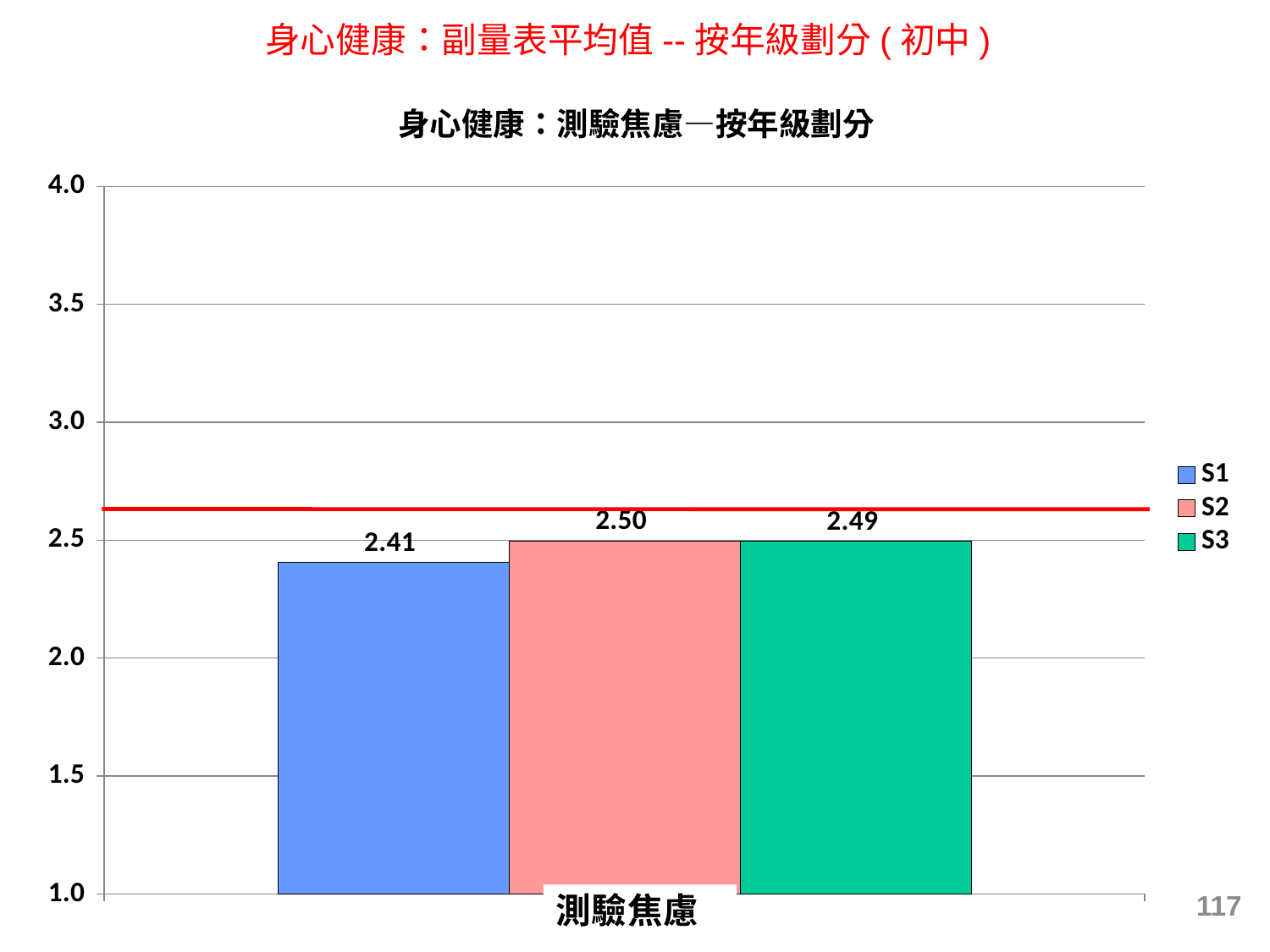
How many series does the legend list? 3 Which series has the highest value in the chart? S2 What kind of chart is shown on the slide? bar chart What is the value for S2 in the 測驗焦慮 chart? 2.50 Which series has the lowest value in the chart? S1 Is the value for S1 greater or less than 2.5? less What is the value for S3 in the 測驗焦慮 chart? 2.49 What is the difference between the S2 and S1 values? 0.09 Which is larger, the value for S1 or the value for S3? S3 What is the difference between the S3 and S1 values? 0.08 What is the title of the chart? 身心健康：測驗焦慮—按年級劃分 What is the value for S1 in the 測驗焦慮 chart? 2.41